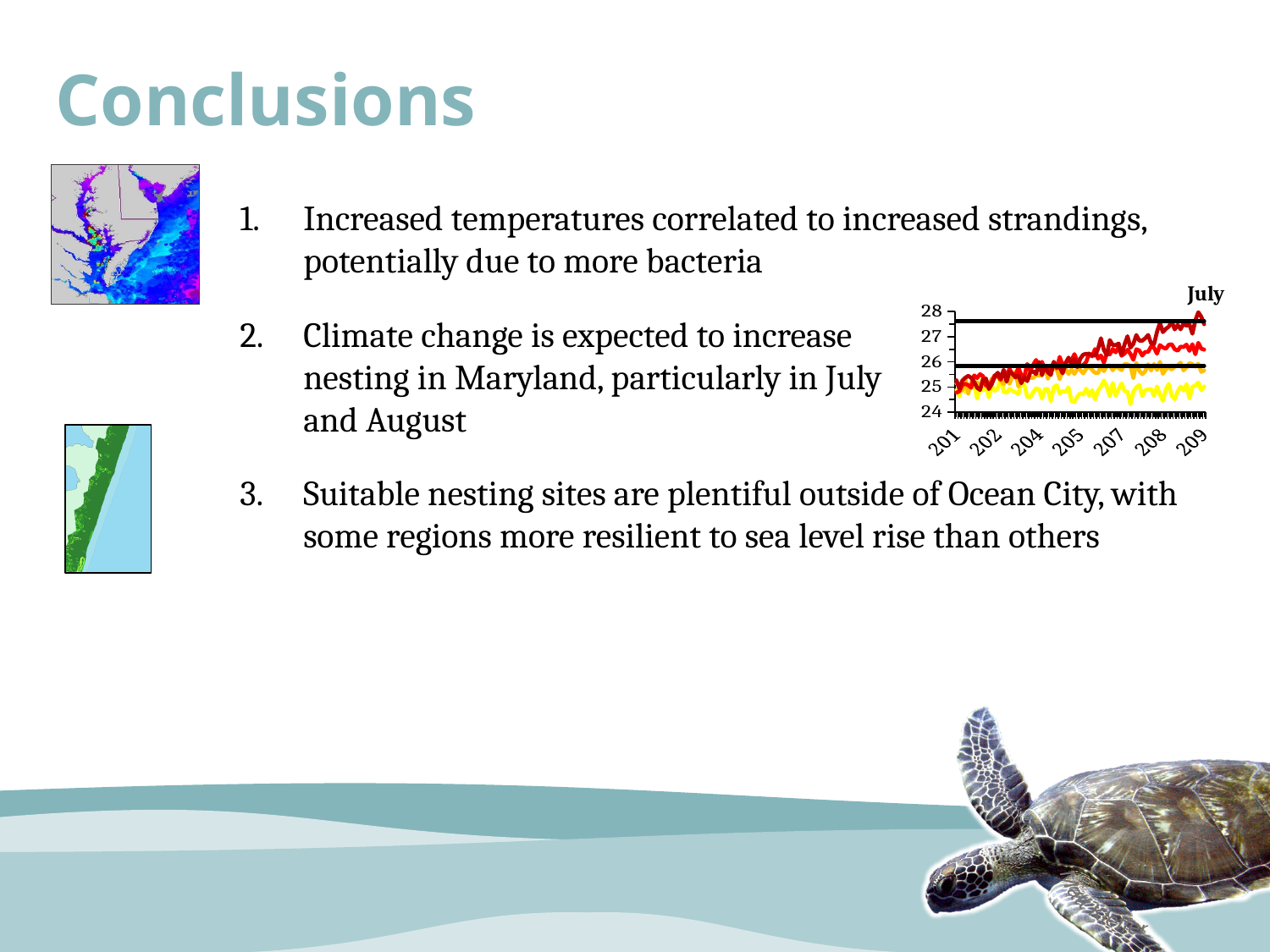
What is the title of the chart on the slide? July What is the highest value shown on the y axis of the chart? 28 Is the yellow line at the right end of the chart greater or less than 26? less Do the red lines in the chart rise or fall from left to right along the x axis? rise How many coloured lines are plotted in the chart? 4 Is the dark red line at the right end of the chart greater or less than 27? greater At the right end of the chart, which line is higher: the dark red line or the yellow line? the dark red line What kind of chart is shown on the slide? line chart What is the lowest value shown on the y axis of the chart? 24 Is the yellow line at the left end of the chart greater or less than 26? less Which coloured line is lowest at the right end of the chart? the yellow line Which coloured line is highest at the right end of the chart? the dark red line